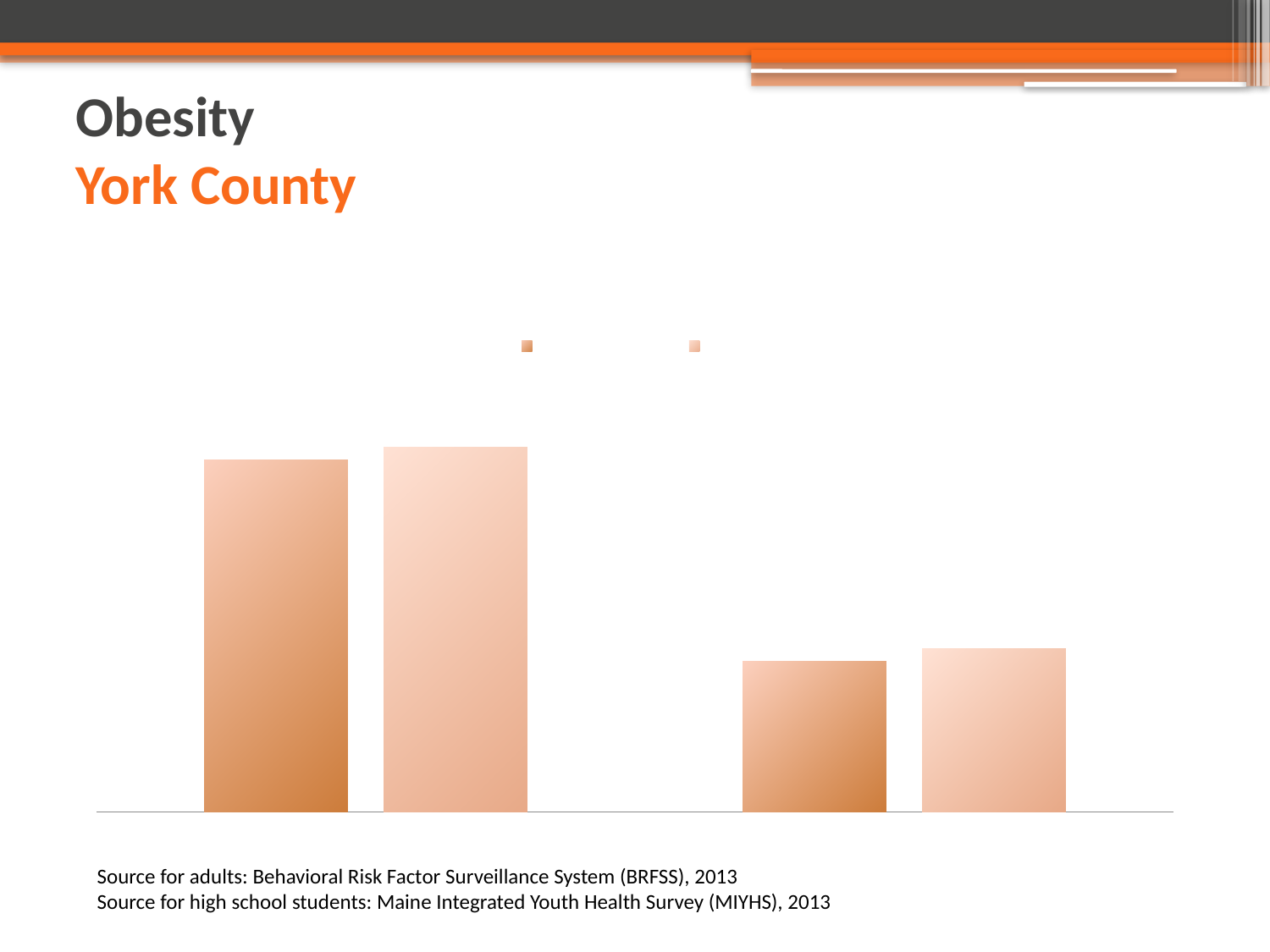
How many bars are plotted in the chart? 4 Which bar is the tallest in the chart, by position? the second bar from the left What kind of chart is shown on the slide? bar chart Within the right group of bars, is the darker orange bar taller or shorter than the lighter bar? shorter Which bar is the shortest in the chart, by position? the third bar from the left Within the left group of bars, is the darker orange bar taller or shorter than the lighter bar? shorter Which group of bars is taller, the left group or the right group? the left group How many series does the chart's legend list? 2 What colour are the bars in the chart? orange How many groups of bars are shown in the chart? 2 What is the title of the slide containing the chart? Obesity York County